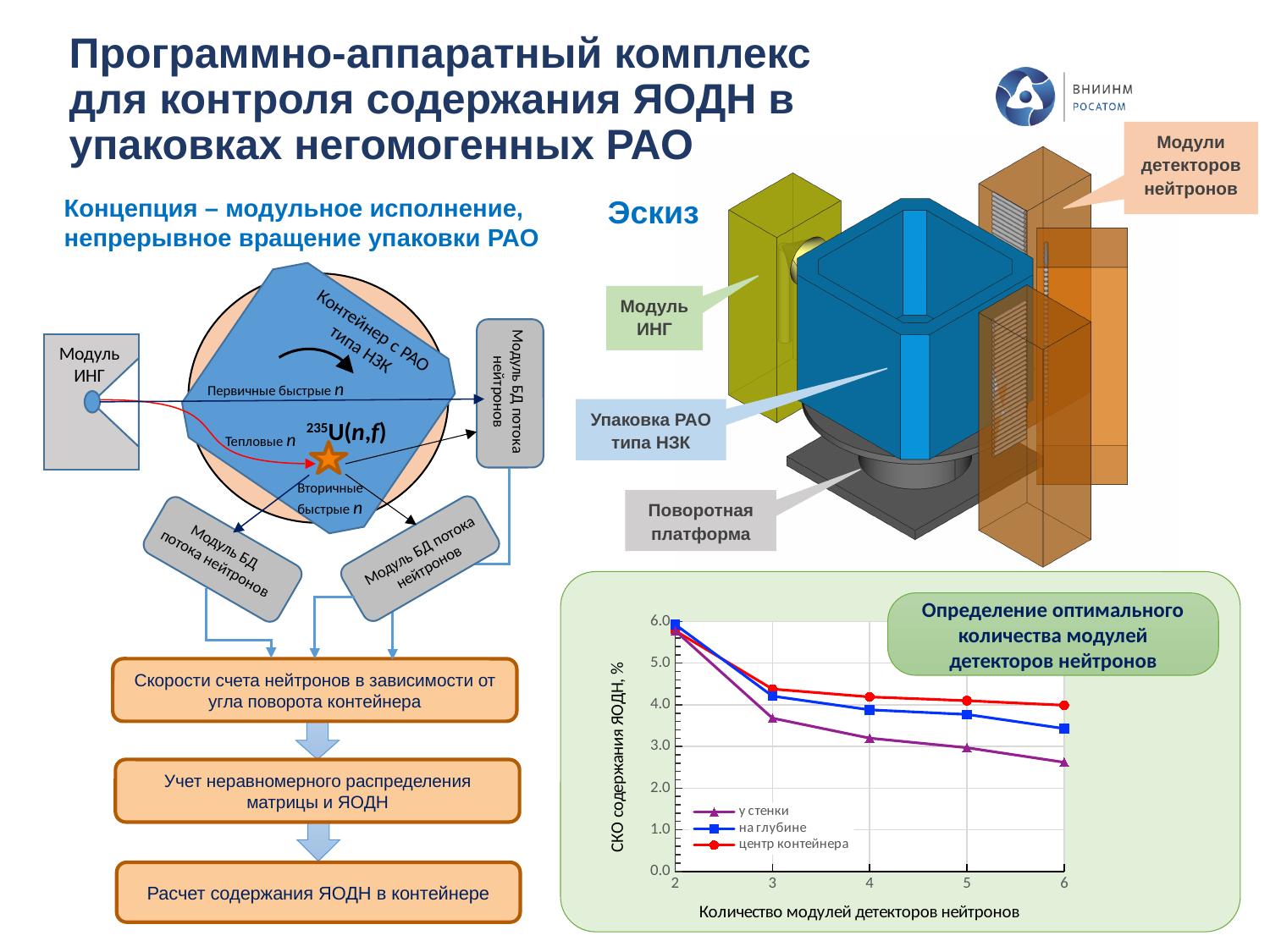
In the line chart, is the value for 'центр контейнера' at 3 detector modules greater or less than 4.0? greater In the line chart, do the values of the series 'у стенки' rise or fall as the number of detector modules increases from 2 to 6? fall What is the y-axis title of the line chart? СКО содержания ЯОДН, % What kind of chart is shown in the bottom-right panel of the slide? line chart In the line chart, which series has the highest value at 6 detector modules? центр контейнера In the line chart, is the value for 'у стенки' at 6 detector modules greater or less than 3.0? less How many x-axis points (numbers of detector modules) are plotted for each series in the line chart? 5 What is the x-axis title of the line chart? Количество модулей детекторов нейтронов In the line chart, is the value for 'на глубине' at 2 detector modules greater or less than 5.0? greater In the line chart, at 4 detector modules, which is larger: the value for 'на глубине' or for 'у стенки'? на глубине In the line chart, which series has the lowest value at 6 detector modules? у стенки How many series does the legend of the line chart list? 3